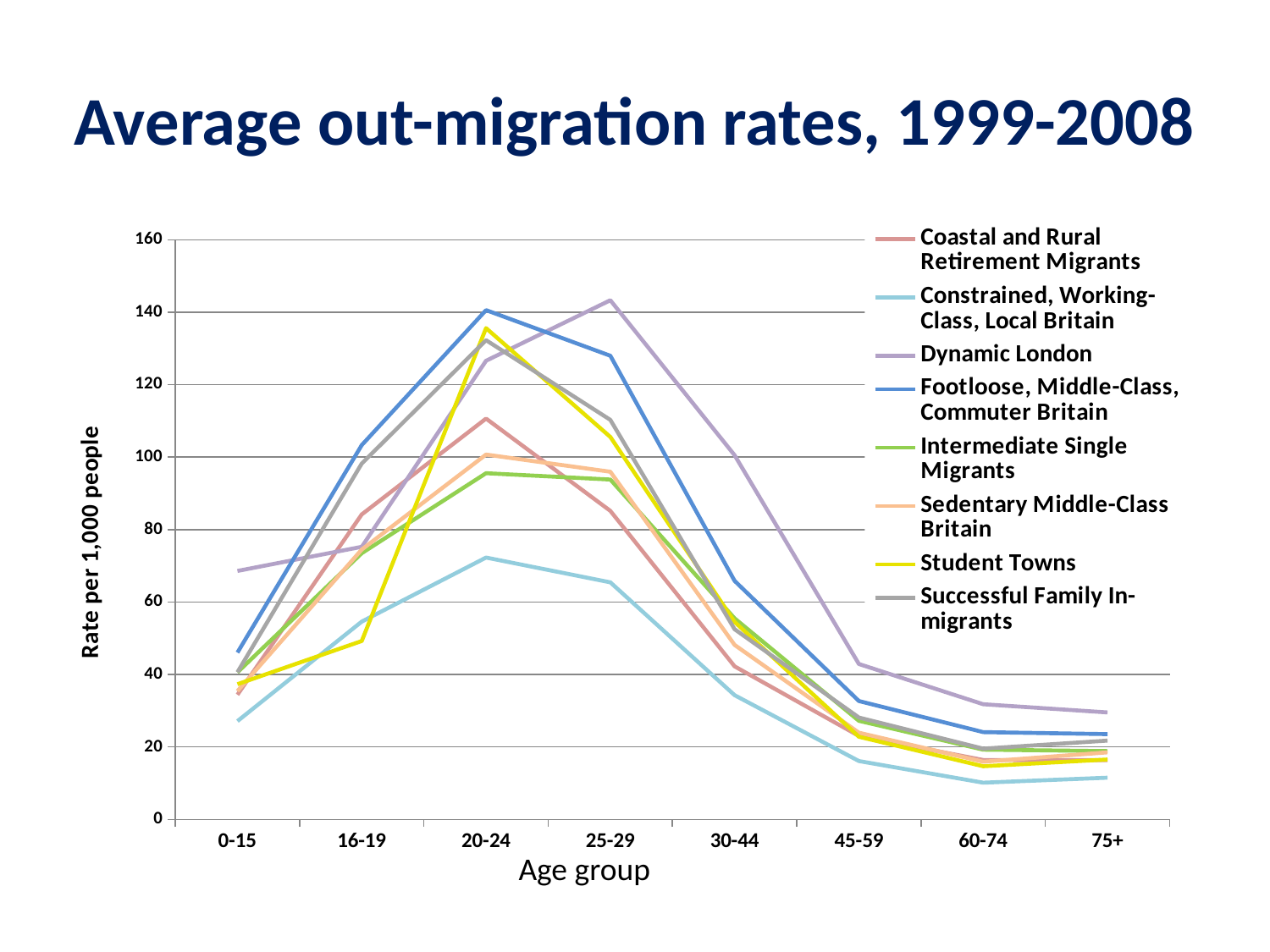
Is the value for Student Towns at age group 16-19 greater or less than 60? less Which series has the lowest value at age group 20-24? Constrained, Working-Class, Local Britain How many series does the legend list? 8 At age group 45-59, which is larger: Dynamic London or Footloose, Middle-Class, Commuter Britain? Dynamic London Is the value for Footloose, Middle-Class, Commuter Britain at age group 20-24 greater or less than 120? greater Which series has the highest value at age group 25-29? Dynamic London Do the values for Footloose, Middle-Class, Commuter Britain rise or fall from age group 25-29 to 75+? fall What kind of chart is shown on the slide? line chart What is the label of the vertical axis? Rate per 1,000 people Is the value for Constrained, Working-Class, Local Britain at age group 20-24 greater or less than 80? less What is the title of the chart? Average out-migration rates, 1999-2008 How many age groups are shown on the x axis? 8